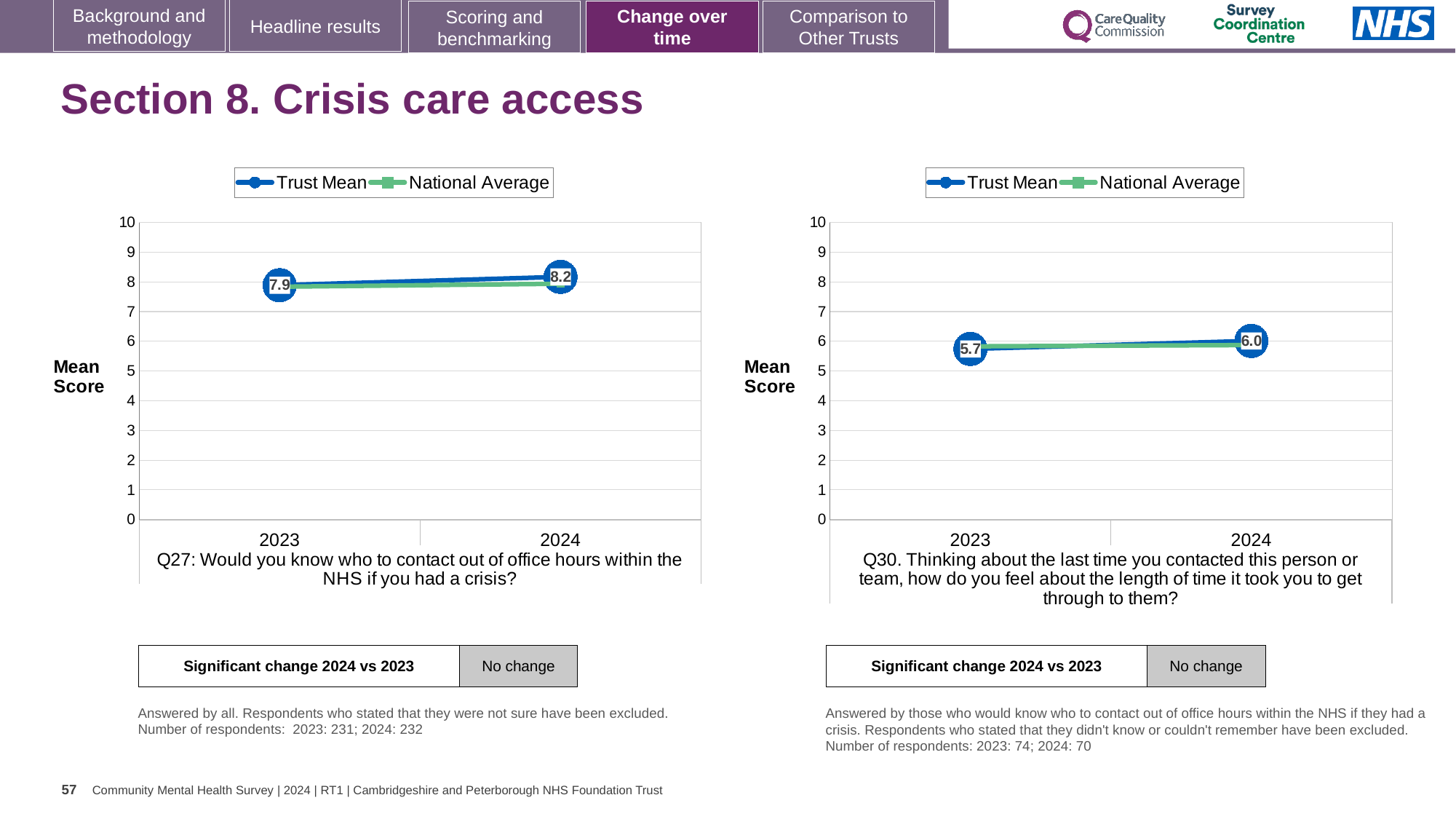
On the right chart (Q30), is the National Average for 2023 greater or less than 7? less On the right chart (Q30), what is the Trust Mean score for 2024? 6.0 On the right chart (Q30), what is the Trust Mean score for 2023? 5.7 On the left chart (Q27), what is the Trust Mean score for 2024? 8.2 On the right chart (Q30), what is the difference between the Trust Mean for 2024 and 2023? 0.3 On the left chart (Q27), by how much did the Trust Mean change from 2023 to 2024? 0.3 On the right chart (Q30), which year has the higher Trust Mean score? 2024 On the left chart (Q27), what is the Trust Mean score for 2023? 7.9 On the left chart (Q27), does the Trust Mean rise or fall from 2023 to 2024? rise How many series does the legend of the left chart (Q27) list? 2 How many years are plotted on the x axis of the right chart (Q30)? 2 What type of chart is the left chart (Q27)? line chart